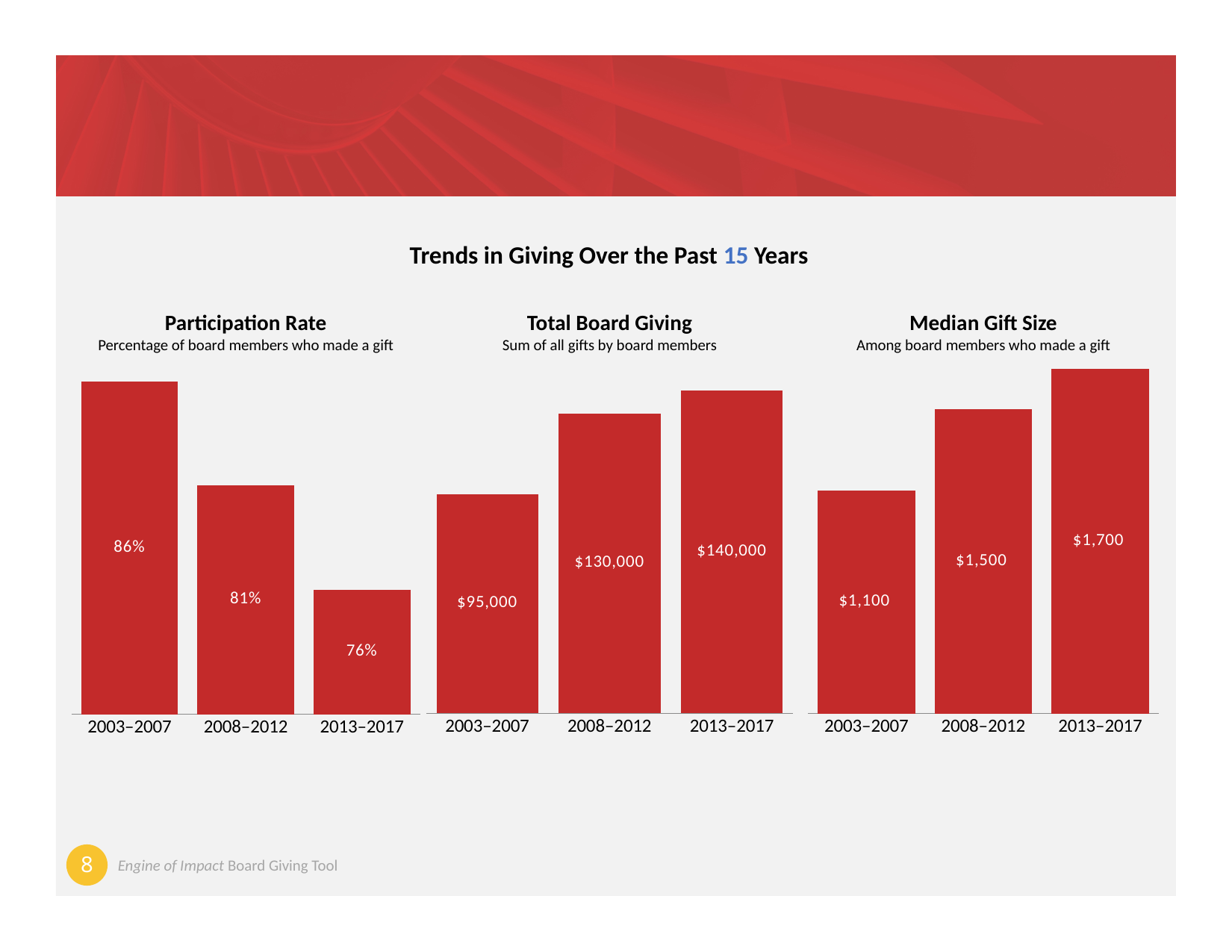
In the Participation Rate chart, what is the value for 2003–2007? 86% In the Total Board Giving chart, which period has the highest total board giving? 2013–2017 What kind of chart is the Median Gift Size chart? bar chart In the Median Gift Size chart, do the values rise or fall from 2003–2007 to 2013–2017? rise In the Median Gift Size chart, what is the value for 2013–2017? $1,700 In the Median Gift Size chart, which is larger, the value for 2003–2007 or the value for 2008–2012? 2008–2012 In the Participation Rate chart, do the values rise or fall from 2003–2007 to 2013–2017? fall In the Participation Rate chart, what is the difference between the 2003–2007 and 2013–2017 values? 10% How many periods are shown in the Total Board Giving chart? 3 In the Participation Rate chart, which period has the lowest participation rate? 2013–2017 In the Total Board Giving chart, what is the difference between the 2013–2017 and 2003–2007 values? $45,000 In the Total Board Giving chart, what is the value for 2008–2012? $130,000